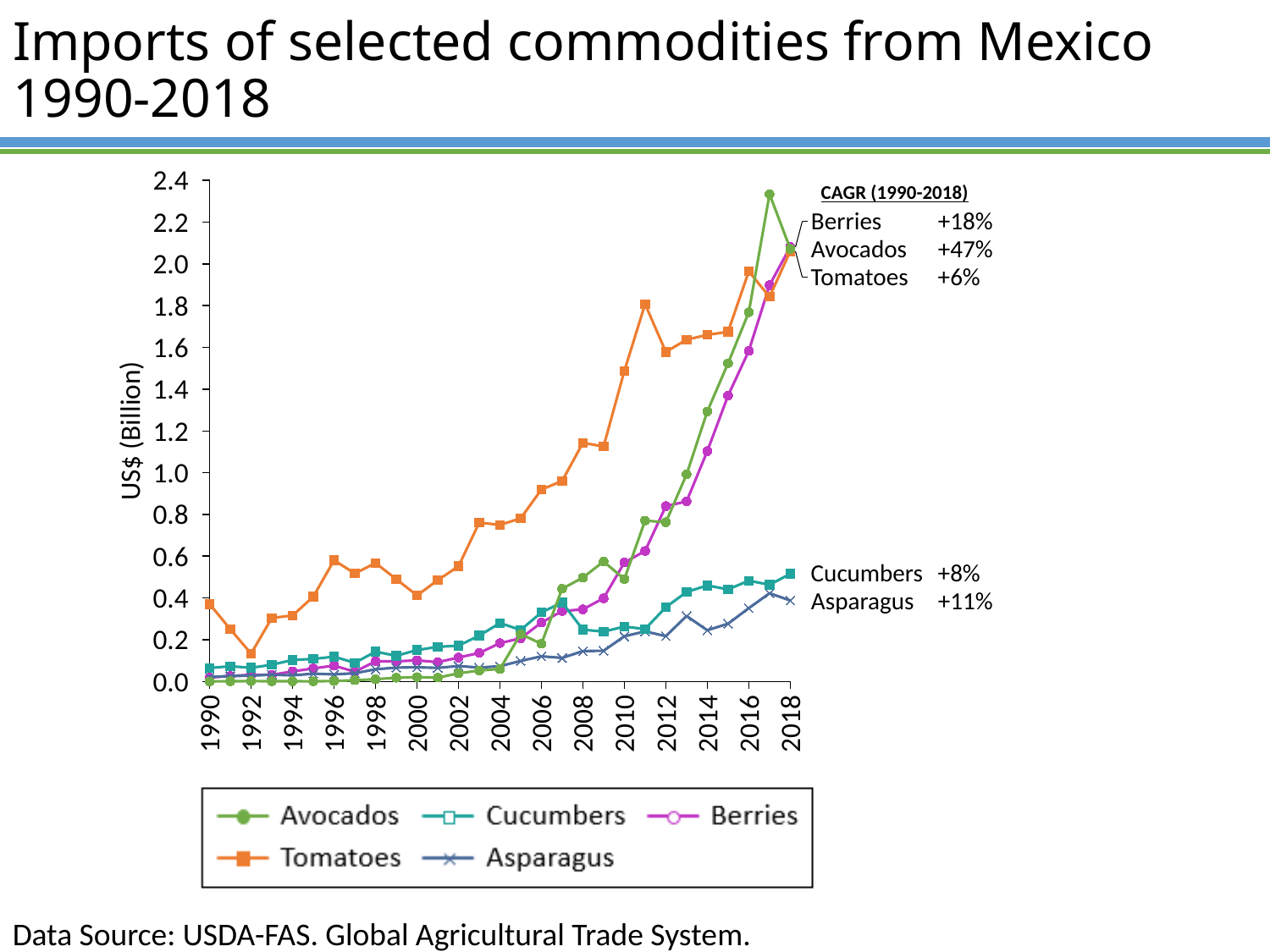
Do Avocado imports rise or fall from 1990 to 2018? rise What is the CAGR (1990-2018) shown for Asparagus? +11% What kind of chart is shown on the slide? line chart Is the value for Tomatoes in 2011 greater or less than 1.6? greater How many series does the legend list? 5 What is the CAGR (1990-2018) shown for Tomatoes? +6% What is the label on the y axis? US$ (Billion) Which commodity has the highest import value in 1990? Tomatoes In 2010, which is larger: the value for Tomatoes or the value for Avocados? Tomatoes Which commodity has the highest import value in 2017? Avocados Is the value for Cucumbers in 2018 greater or less than 0.6? less What is the CAGR (1990-2018) shown for Avocados? +47%